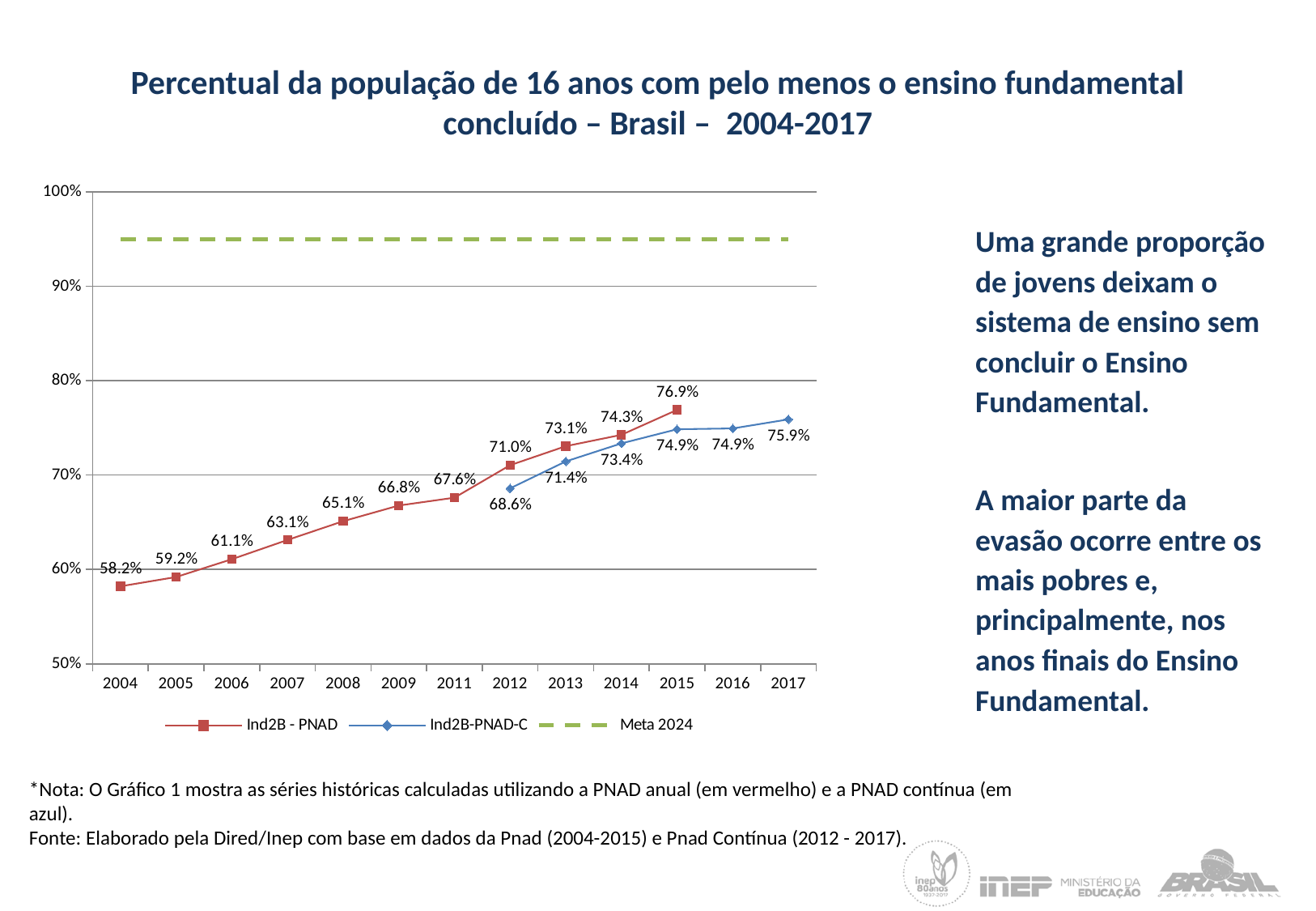
In which year does the Ind2B-PNAD-C series have its lowest value? 2012 What is the difference between the Ind2B - PNAD and Ind2B-PNAD-C values in 2013? 1.7 percentage points What is the value of the Ind2B-PNAD-C series in 2016? 74.9% In 2014, which series has the higher value, Ind2B - PNAD or Ind2B-PNAD-C? Ind2B - PNAD What is the value of the Ind2B-PNAD-C series in 2017? 75.9% In which year does the Ind2B - PNAD series reach its highest value? 2015 What kind of chart is shown on the slide? line chart What is the value of the Ind2B - PNAD series in 2004? 58.2% Is the Meta 2024 line greater or less than 90%? greater How many years are shown on the x axis? 13 By how many percentage points did the Ind2B - PNAD series increase from 2004 to 2015? 18.7 percentage points How many series does the legend list? 3